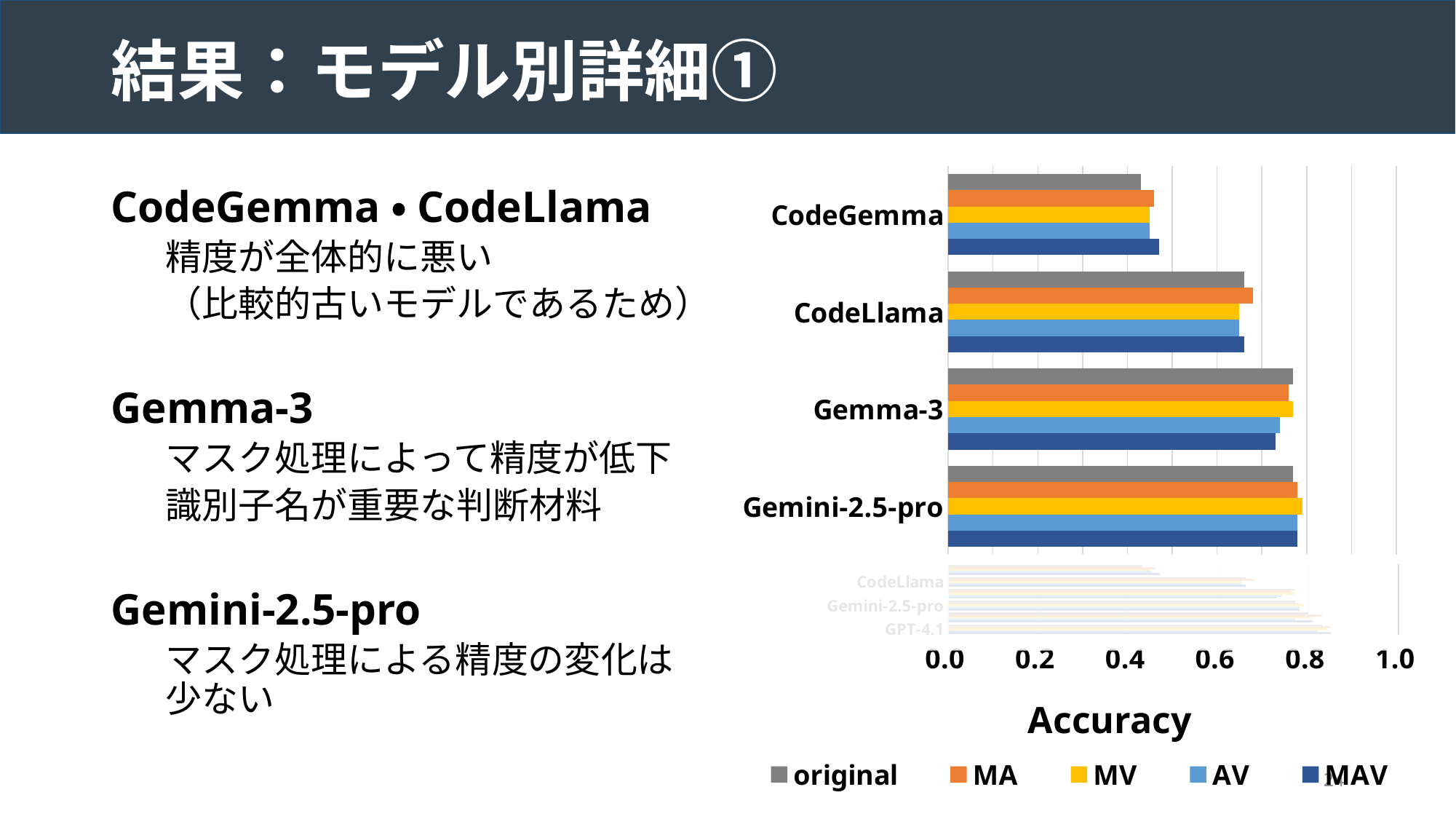
Is the original accuracy for CodeGemma greater or less than 0.6? less Is the original accuracy for CodeLlama greater or less than 0.6? greater Is the MAV accuracy for CodeGemma greater or less than 0.8? less Which model has the lowest original accuracy? CodeGemma What kind of chart is shown on the slide? bar chart Which is larger for Gemma-3, the original accuracy or the MAV accuracy? original Which is larger, the original accuracy for CodeLlama or the original accuracy for Gemini-2.5-pro? Gemini-2.5-pro Which is larger, the MA accuracy for CodeGemma or the MA accuracy for CodeLlama? CodeLlama Which series in the legend is shown in orange? MA What is the title of the horizontal axis of the chart? Accuracy How many series does the chart legend list? 5